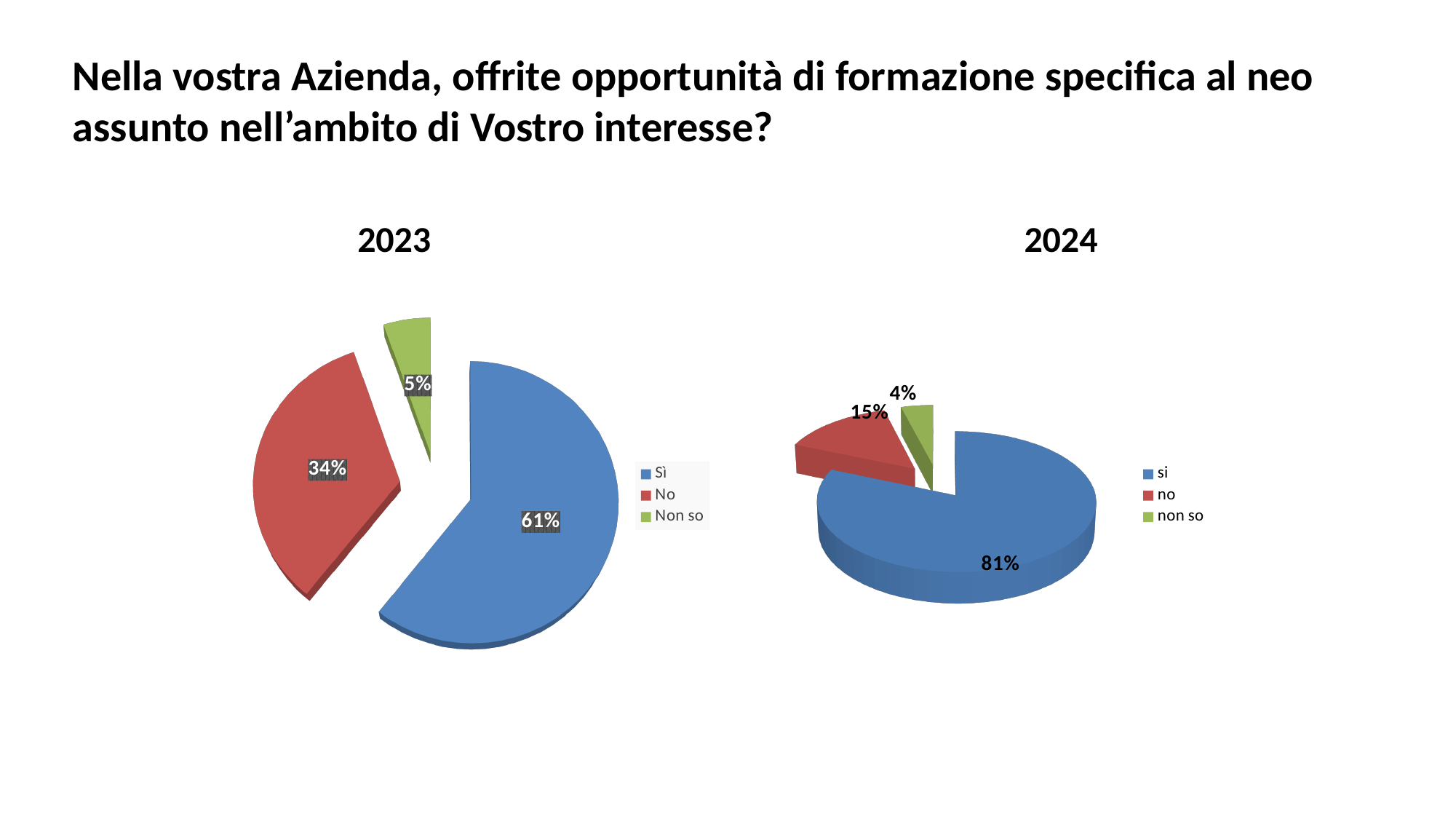
What type of chart is used for the 2023 data? Pie chart In the 2023 chart, what percentage of respondents answered 'Non so'? 5% In the 2024 chart, what percentage of respondents answered 'no'? 15% In the 2023 chart, what is the difference between the 'No' share and the 'Non so' share? 29 percentage points In the 2023 chart, what percentage of respondents answered 'No'? 34% In the 2024 chart, which answer has the smallest share? non so What is the difference between the 'Sì' share in the 2024 chart and the 'Sì' share in the 2023 chart? 20 percentage points In the 2023 chart, what percentage of respondents answered 'Sì'? 61% In the 2024 chart, what percentage of respondents answered 'si'? 81% How many categories does the legend of the 2024 chart list? 3 In the 2023 chart, which answer has the largest share? Sì In the 2024 chart, what percentage of respondents answered 'non so'? 4%